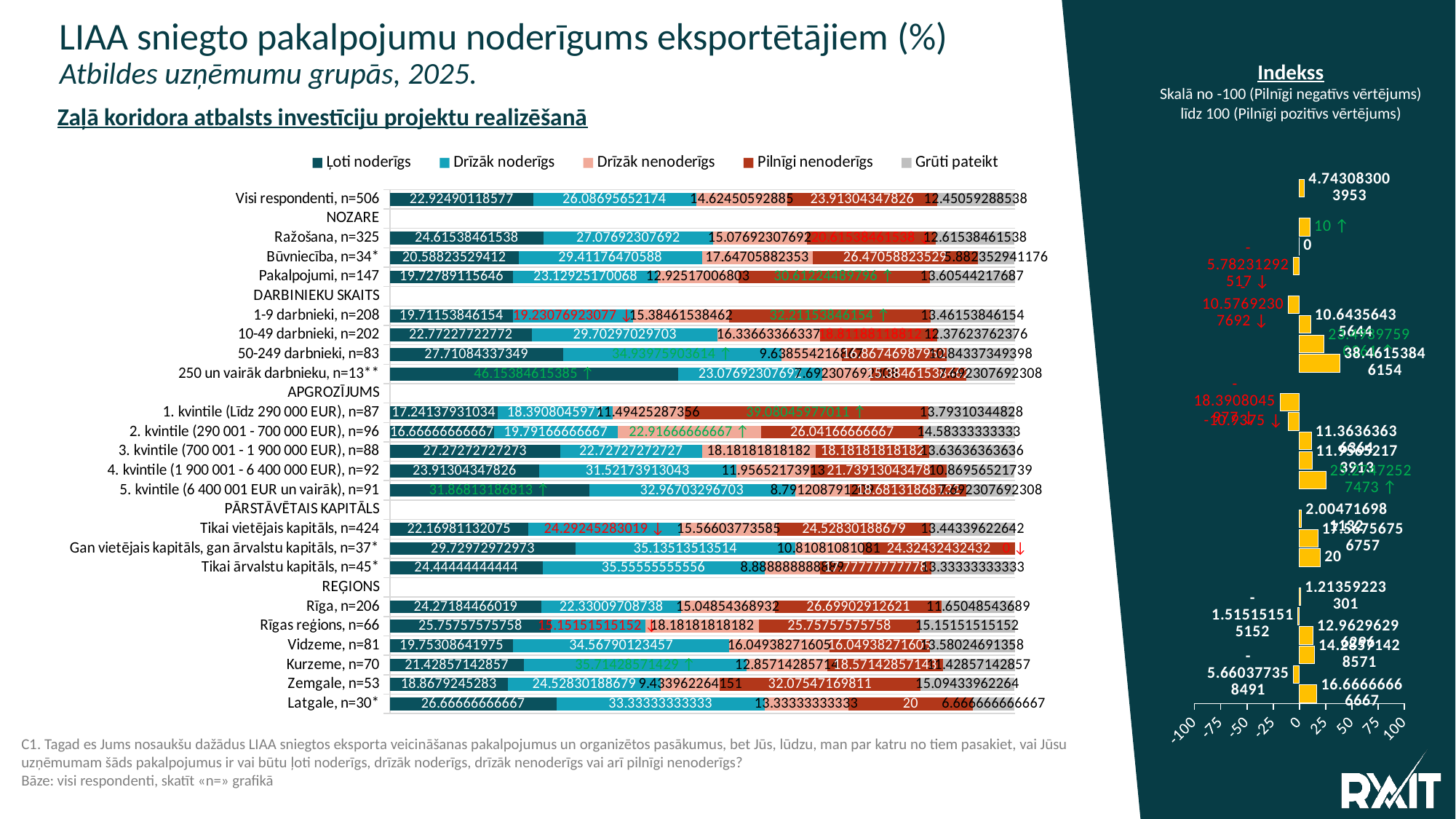
In the Indekss chart on the right, what is the index value for Būvniecība, n=34*? 0 In the stacked bar chart, what is the difference between 'Pilnīgi nenoderīgs' and 'Grūti pateikt' for Latgale, n=30*? 13.333333333333 How many respondent groups are plotted in the stacked bar chart? 22 In the Indekss chart on the right, is the index value for 250 un vairāk darbinieku, n=13** greater or less than 25? greater In the stacked bar chart, what is the value of 'Ļoti noderīgs' for Visi respondenti, n=506? 22.92490118577 In the stacked bar chart, what is the value of 'Pilnīgi nenoderīgs' for Latgale, n=30*? 20 In the Indekss chart on the right, what is the difference between the index for Tikai ārvalstu kapitāls, n=45* and Ražošana, n=325? 10 What kind of chart is the main chart on the left? Stacked bar chart In the stacked bar chart, for Latgale, n=30*, which is larger: 'Drīzāk noderīgs' or 'Ļoti noderīgs'? Drīzāk noderīgs In the stacked bar chart, which respondent group has the highest 'Ļoti noderīgs' value? 250 un vairāk darbinieku, n=13** In the stacked bar chart, what is the value of 'Drīzāk noderīgs' for Latgale, n=30*? 33.33333333333 How many series does the legend of the stacked bar chart list? 5